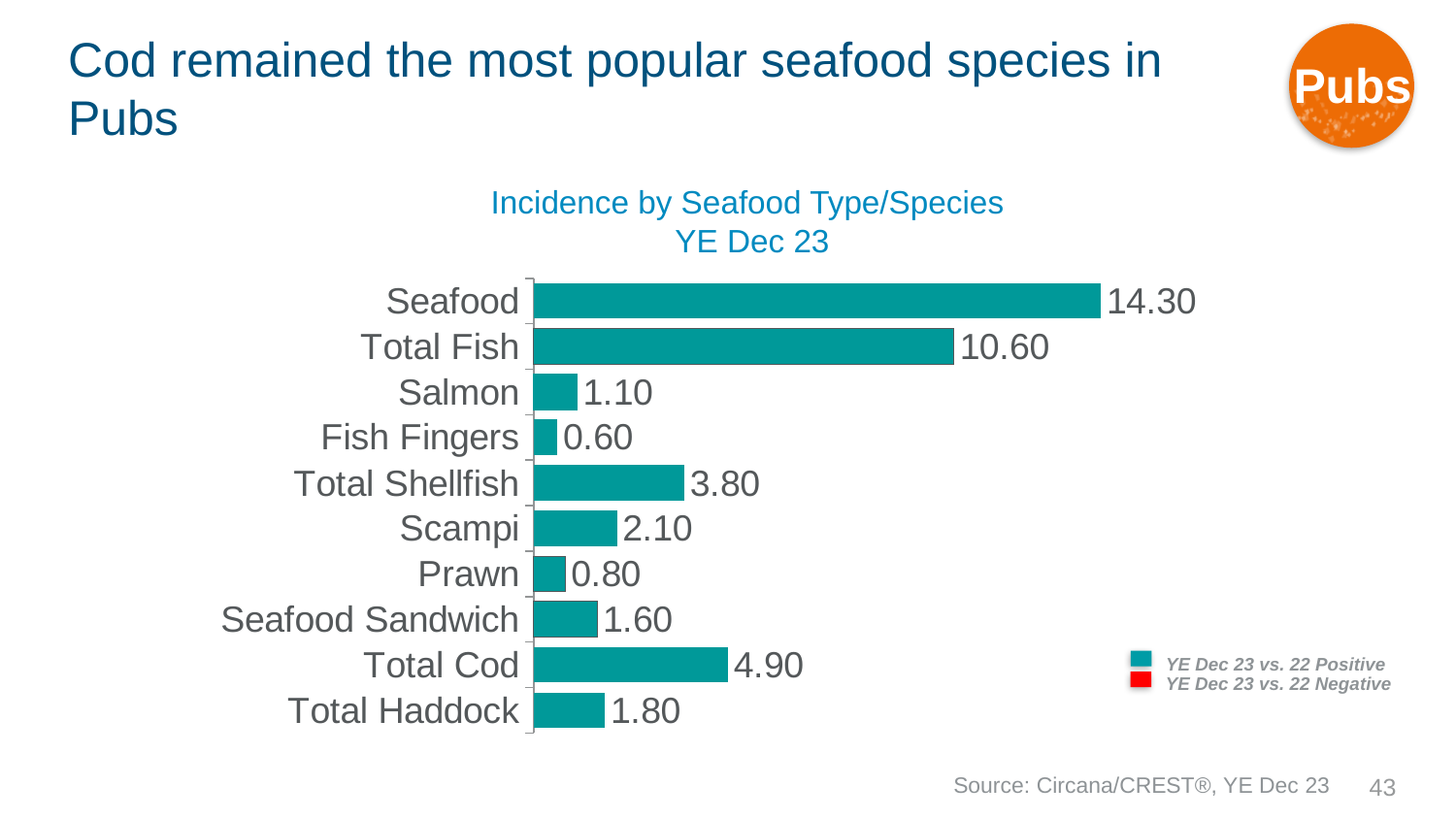
What is the title of the chart? Incidence by Seafood Type/Species YE Dec 23 What is the value for Total Cod? 4.90 How many categories are shown in the chart? 10 What kind of chart is shown on the slide? Bar chart Which category has the lowest value? Fish Fingers What is the difference between the values for Total Cod and Total Haddock? 3.10 What is the difference between the values for Seafood and Total Fish? 3.70 Which is larger, the value for Prawn or the value for Fish Fingers? Prawn What is the value for Salmon? 1.10 Which is larger, the value for Scampi or the value for Seafood Sandwich? Scampi What is the value for Total Shellfish? 3.80 Which category has the highest value? Seafood